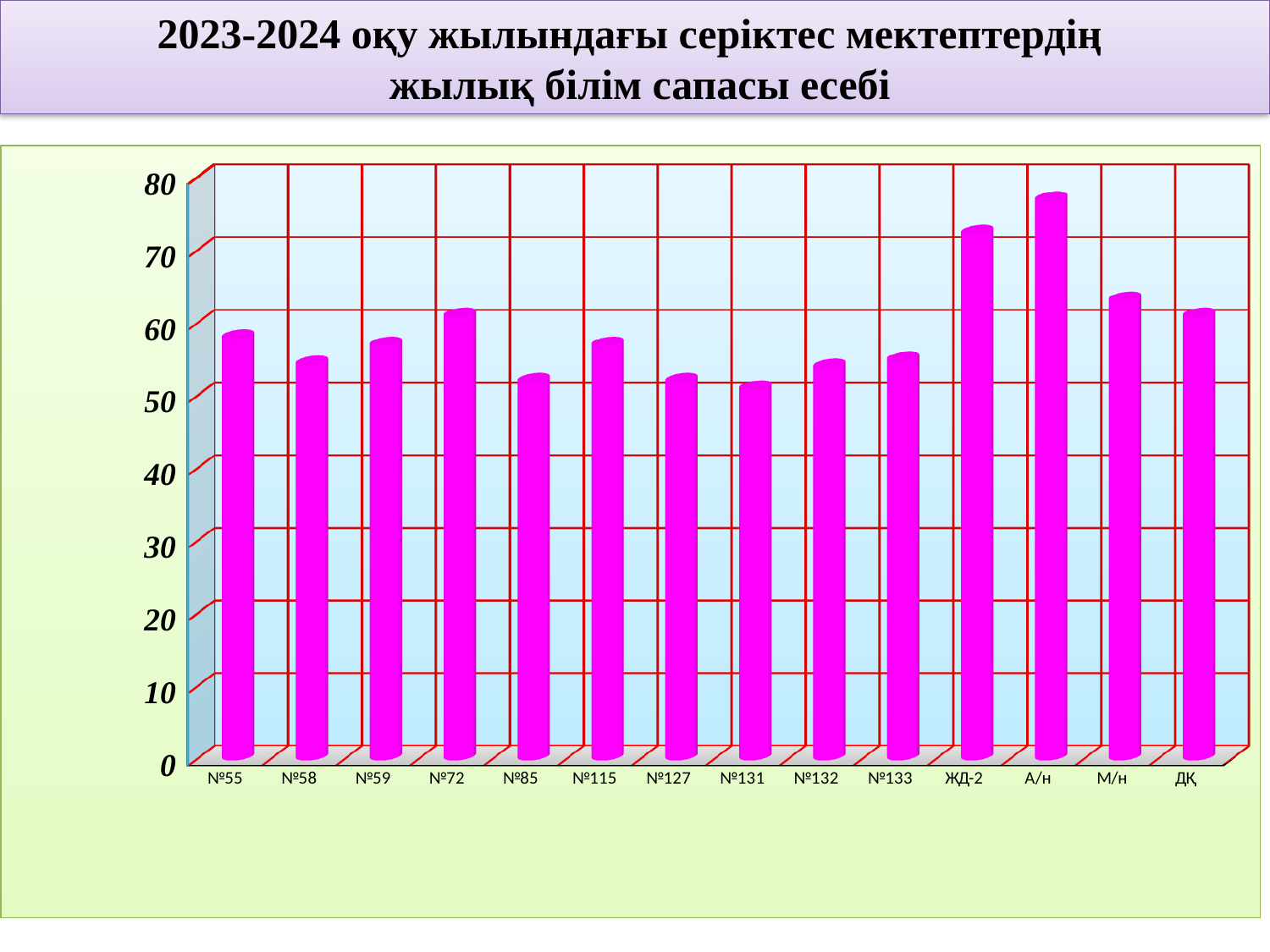
How many categories (schools) are shown along the x axis? 14 Is the value for №131 greater or less than 60? less Is the value for №58 greater or less than 60? less Is the value for ЖД-2 greater or less than 70? greater Which category has the highest bar? А/н Which is larger, the value for ЖД-2 or the value for М/н? ЖД-2 What kind of chart is shown on the slide? bar chart What colour are the bars in the chart? magenta (pink) Which is larger, the value for №72 or the value for №58? №72